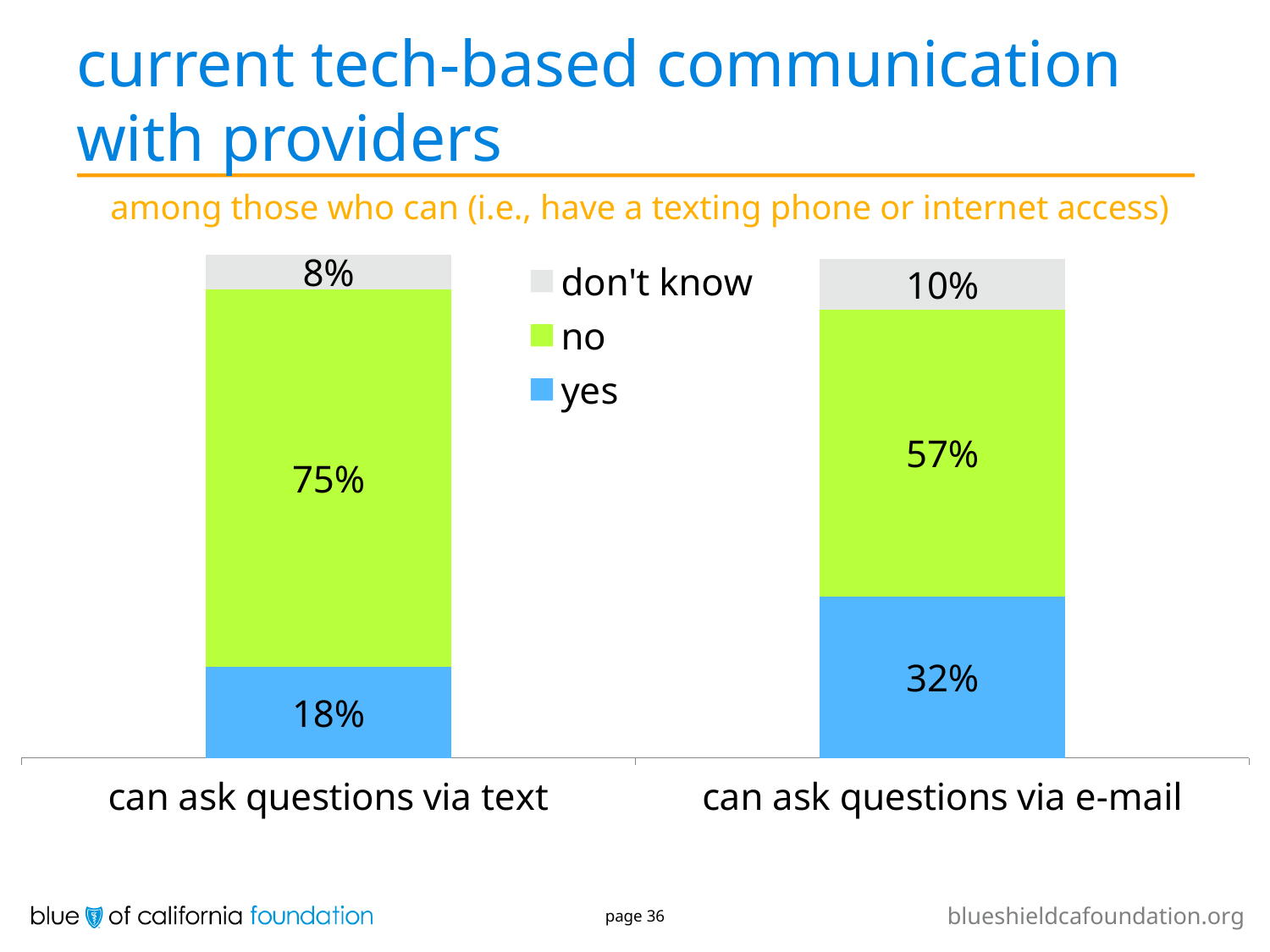
What is the total of the stacked bar for "can ask questions via text"? 101% How many series does the legend list? 3 What percentage answered "don't know" for "can ask questions via text"? 8% What is the difference between the "yes" percentages for e-mail and text? 14% What percentage answered "yes" for "can ask questions via text"? 18% What kind of chart is shown on the slide? stacked bar chart Which category has the higher "no" percentage? can ask questions via text What percentage answered "yes" for "can ask questions via e-mail"? 32% Which colour represents the "yes" series in the legend? blue What is the difference between the "no" percentages for text and e-mail? 18% How many categories are shown on the x axis? 2 What percentage answered "no" for "can ask questions via e-mail"? 57%